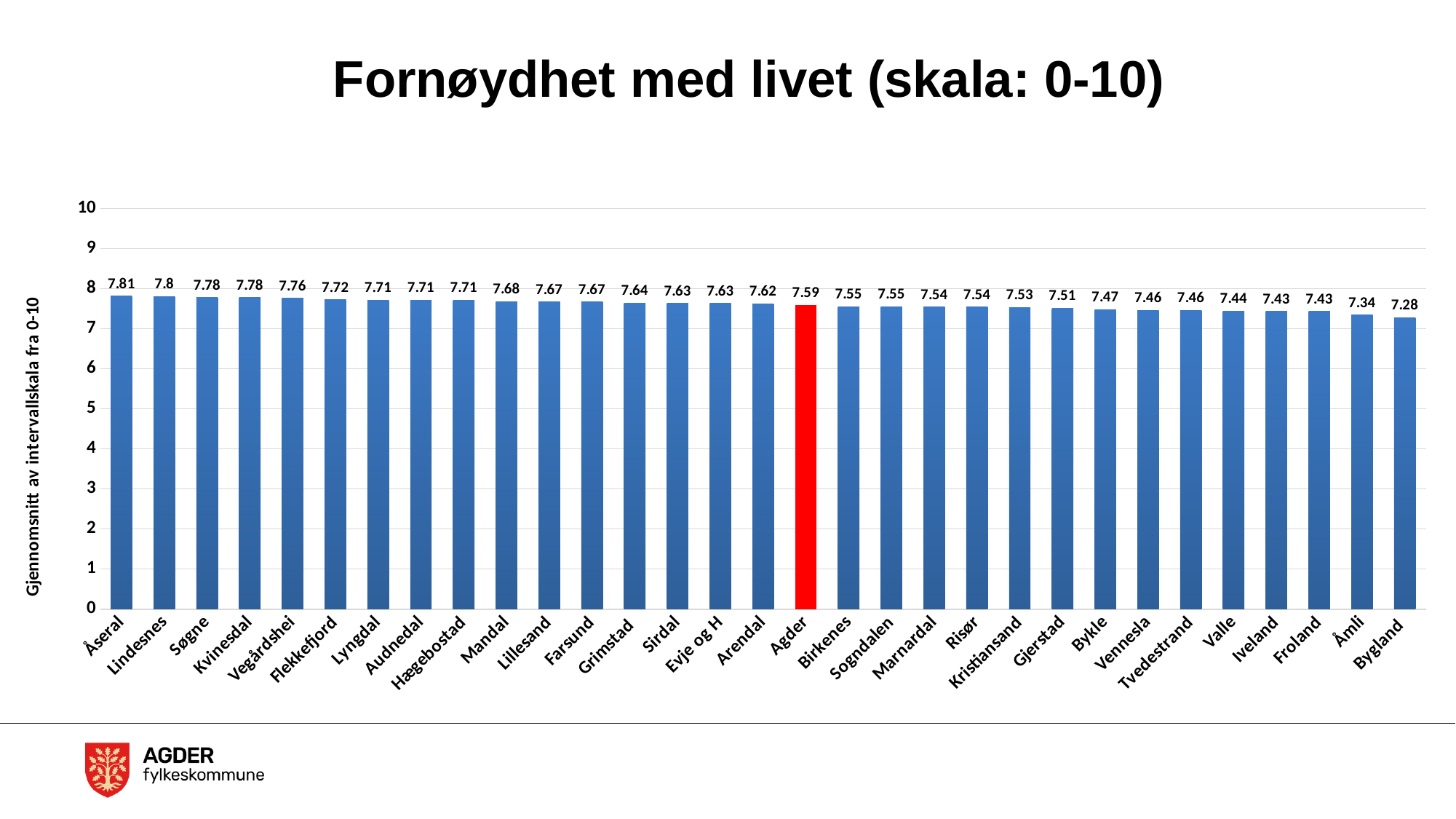
What is the difference between the values for Åseral and Bygland? 0.53 What is the value for Bykle? 7.47 What is the difference between the values for Agder and Arendal? 0.03 Which category has the lowest value? Bygland What is the value for Kristiansand? 7.53 Is the value for Grimstad greater or less than 8? less Which category has the highest value? Åseral What kind of chart is shown on the slide? bar chart Which bar is coloured red instead of blue? Agder What is the value for Agder? 7.59 How many categories are shown on the x axis? 31 Which is larger, the value for Lindesnes or the value for Åmli? Lindesnes